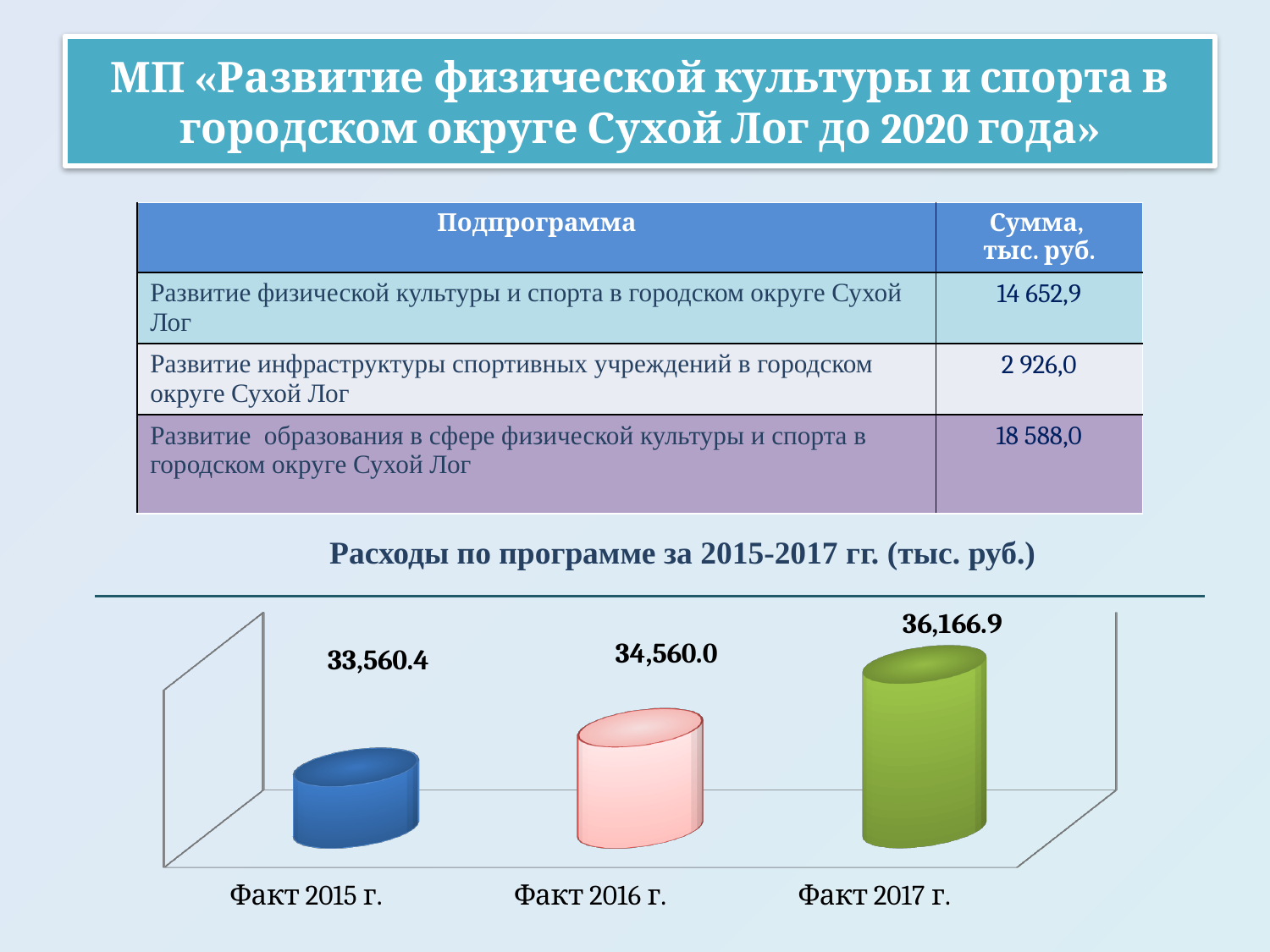
What is the difference between the values for Факт 2017 г. and Факт 2015 г.? 2,606.5 Which is larger, the value for Факт 2016 г. or the value for Факт 2017 г.? Факт 2017 г. How many categories are shown in the chart? 3 What is the value for Факт 2017 г. in the chart? 36,166.9 What kind of chart is shown on the slide? Bar chart What is the difference between the values for Факт 2017 г. and Факт 2016 г.? 1,606.9 What is the value for Факт 2016 г. in the chart? 34,560.0 Which category has the lowest value in the chart? Факт 2015 г. What is the difference between the values for Факт 2016 г. and Факт 2015 г.? 999.6 What is the value for Факт 2015 г. in the chart? 33,560.4 Which category has the highest value in the chart? Факт 2017 г. Do the values rise or fall from Факт 2015 г. to Факт 2017 г.? Rise